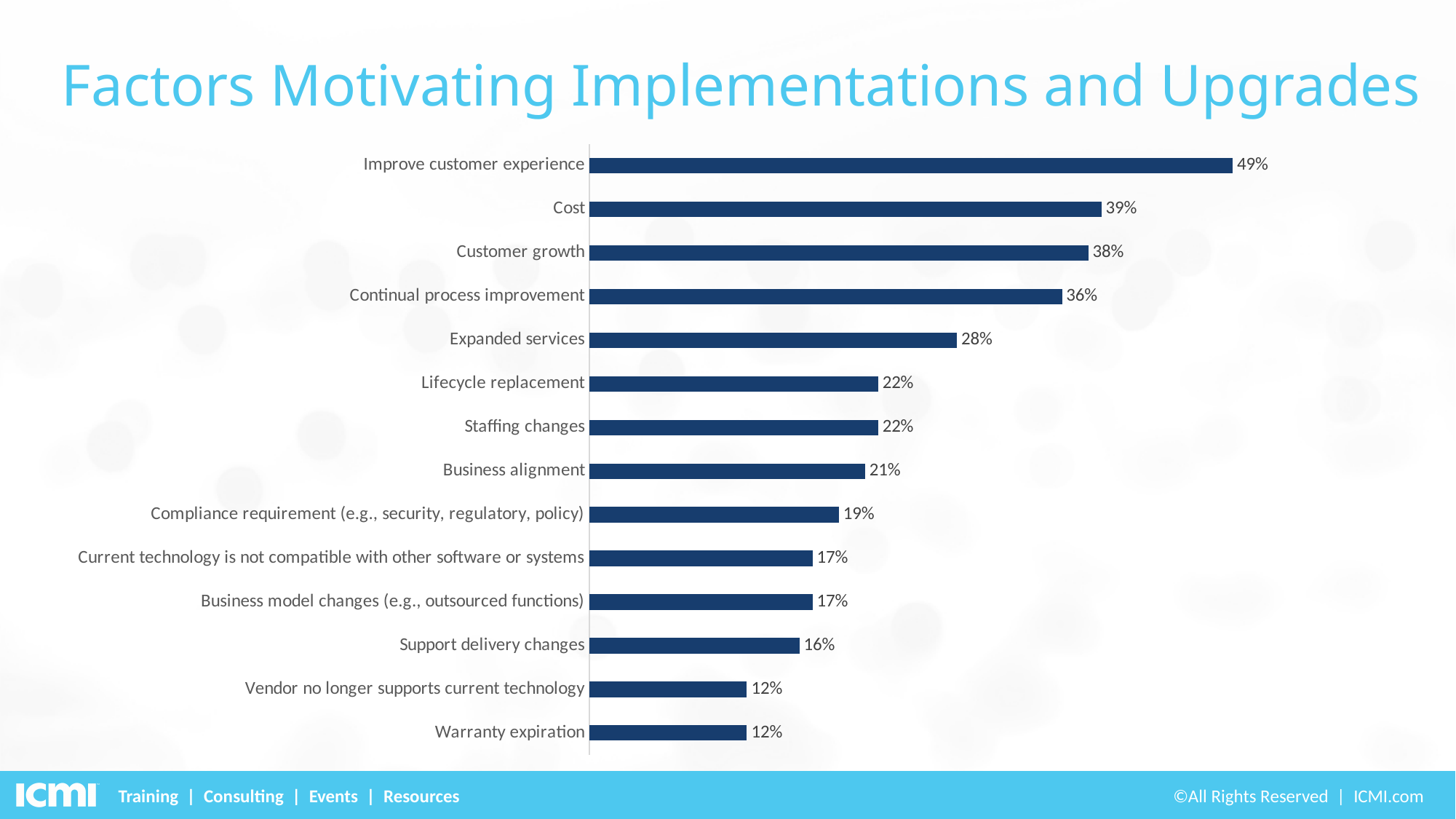
What is the value for Improve customer experience? 49% Which factor has the highest value? Improve customer experience What is the title of the slide? Factors Motivating Implementations and Upgrades What is the value for Support delivery changes? 16% Which is larger, the value for Business alignment or the value for Support delivery changes? Business alignment Which is larger, the value for Continual process improvement or the value for Expanded services? Continual process improvement What is the difference between the values for Improve customer experience and Warranty expiration? 37% What is the value for Expanded services? 28% What is the difference between the values for Cost and Customer growth? 1% What is the value for Compliance requirement (e.g., security, regulatory, policy)? 19% How many factors are shown in the chart? 14 What kind of chart is shown on the slide? Bar chart